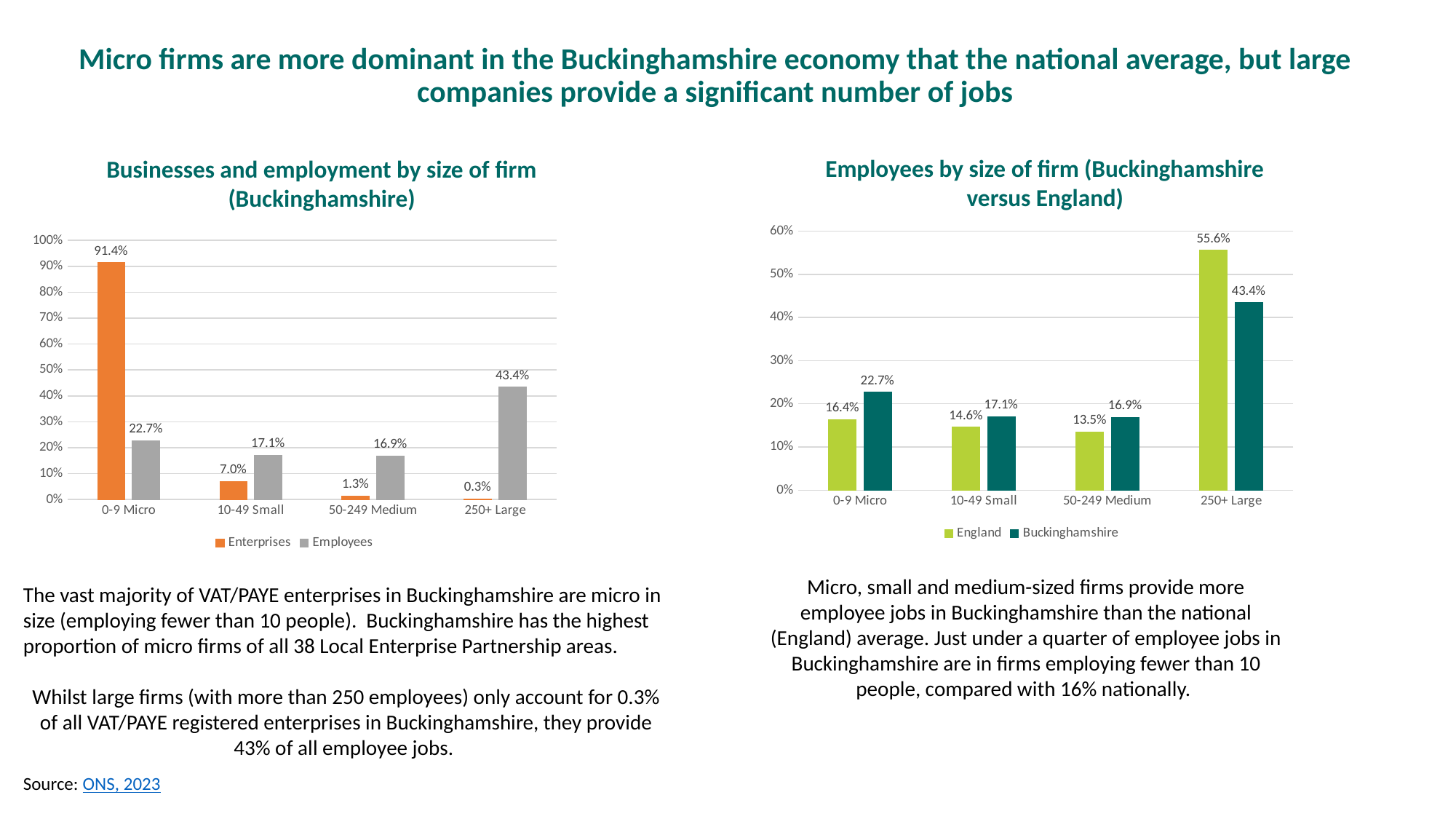
In the 'Businesses and employment by size of firm (Buckinghamshire)' chart, how many series does the legend list? 2 In the 'Employees by size of firm (Buckinghamshire versus England)' chart, what is the England value for 0-9 Micro? 16.4% What kind of chart is 'Employees by size of firm (Buckinghamshire versus England)'? Bar chart In the 'Businesses and employment by size of firm (Buckinghamshire)' chart, what colour are the Enterprises bars? Orange In the 'Employees by size of firm (Buckinghamshire versus England)' chart, which size category has the highest England value? 250+ Large In the 'Businesses and employment by size of firm (Buckinghamshire)' chart, what is the difference between the Employees values for 10-49 Small and 50-249 Medium? 0.2% In the 'Employees by size of firm (Buckinghamshire versus England)' chart, which is larger for 0-9 Micro: England or Buckinghamshire? Buckinghamshire In the 'Employees by size of firm (Buckinghamshire versus England)' chart, what is the difference between the England and Buckinghamshire values for 250+ Large? 12.2% In the 'Businesses and employment by size of firm (Buckinghamshire)' chart, which size category has the lowest Enterprises value? 250+ Large In the 'Businesses and employment by size of firm (Buckinghamshire)' chart, what is the Employees value for 250+ Large? 43.4% In the 'Businesses and employment by size of firm (Buckinghamshire)' chart, what is the Enterprises value for 0-9 Micro? 91.4% In the 'Employees by size of firm (Buckinghamshire versus England)' chart, what is the Buckinghamshire value for 50-249 Medium? 16.9%